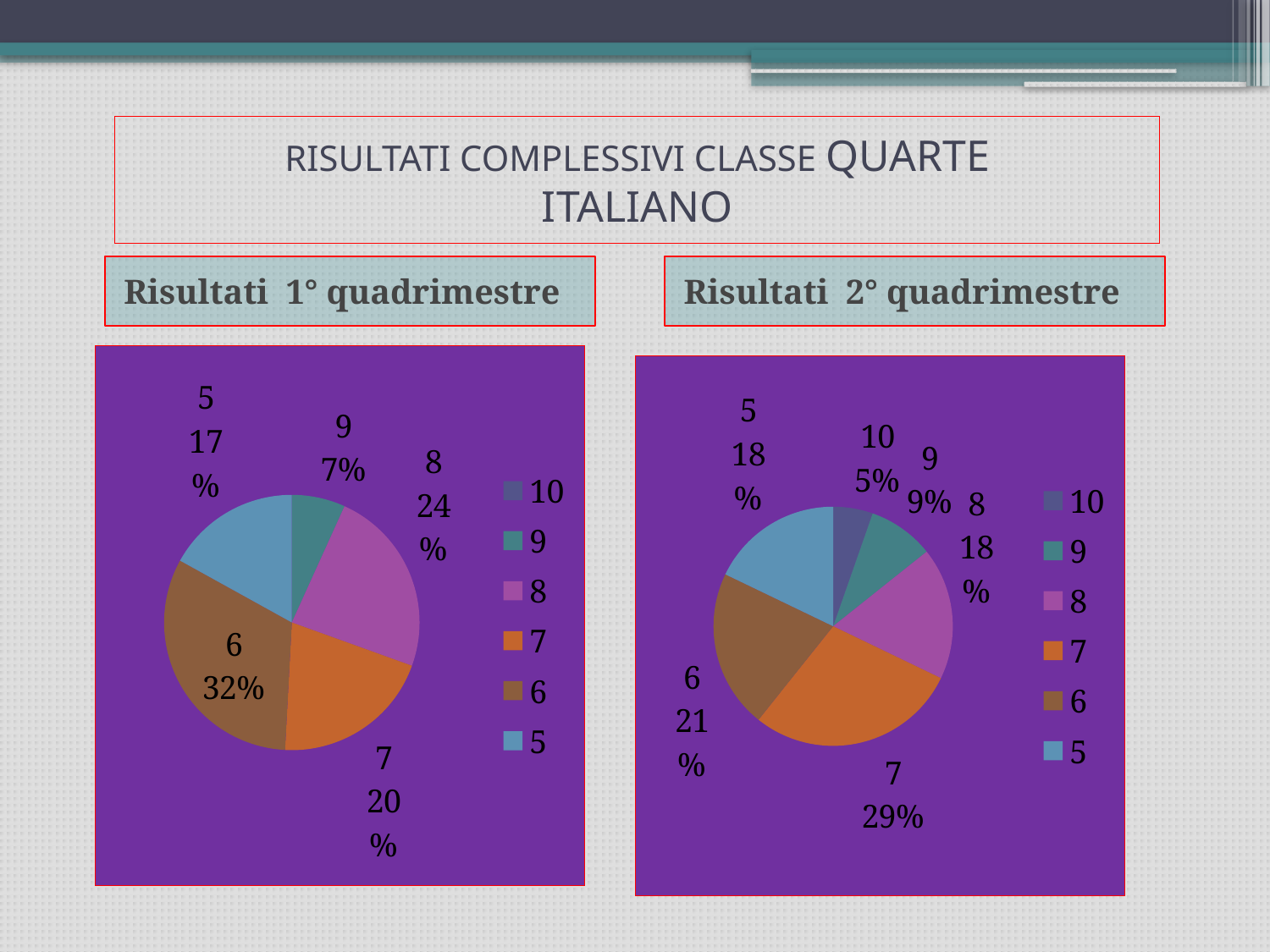
What type of chart is used for 'Risultati 1° quadrimestre'? Pie chart In the 'Risultati 1° quadrimestre' pie chart, which grade has the largest slice? 6 In the 'Risultati 1° quadrimestre' pie chart, what is the difference in percentage points between grade 6 and grade 7? 12 How many entries does the legend of the 'Risultati 2° quadrimestre' chart list? 6 In the 'Risultati 1° quadrimestre' pie chart, what percentage is shown for grade 6? 32% In the 'Risultati 2° quadrimestre' pie chart, which is larger, the slice for grade 6 or the slice for grade 5? 6 In the 'Risultati 1° quadrimestre' pie chart, which labelled grade has the smallest slice? 9 In the 'Risultati 2° quadrimestre' pie chart, which grade has the smallest slice? 10 In the 'Risultati 2° quadrimestre' pie chart, what percentage is shown for grade 10? 5% In the 'Risultati 2° quadrimestre' pie chart, what percentage is shown for grade 7? 29% In the 'Risultati 2° quadrimestre' pie chart, which grade has the largest slice? 7 In the 'Risultati 1° quadrimestre' pie chart, what percentage is shown for grade 8? 24%